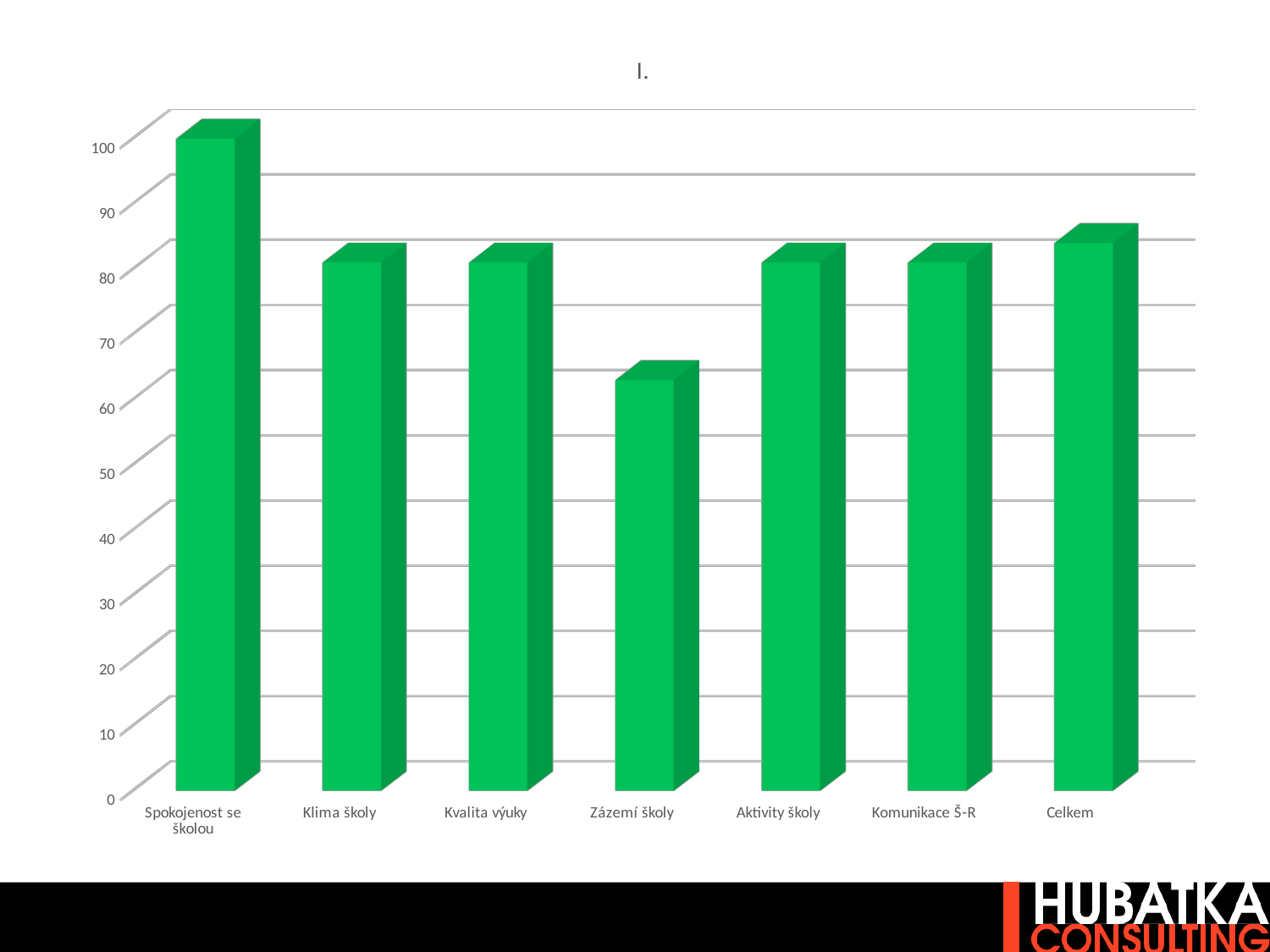
Is the value for Zázemí školy greater or less than 50? greater Which category has the highest bar in the chart? Spokojenost se školou Which category has the lowest bar in the chart? Zázemí školy Is the value for Celkem greater or less than 90? less Is the value for Klima školy greater or less than 70? greater Which is larger, the value for Spokojenost se školou or the value for Aktivity školy? Spokojenost se školou What kind of chart is shown on the slide? bar chart What is the title of the chart? I. Which is larger, the value for Celkem or the value for Zázemí školy? Celkem How many categories are shown on the x axis of the chart? 7